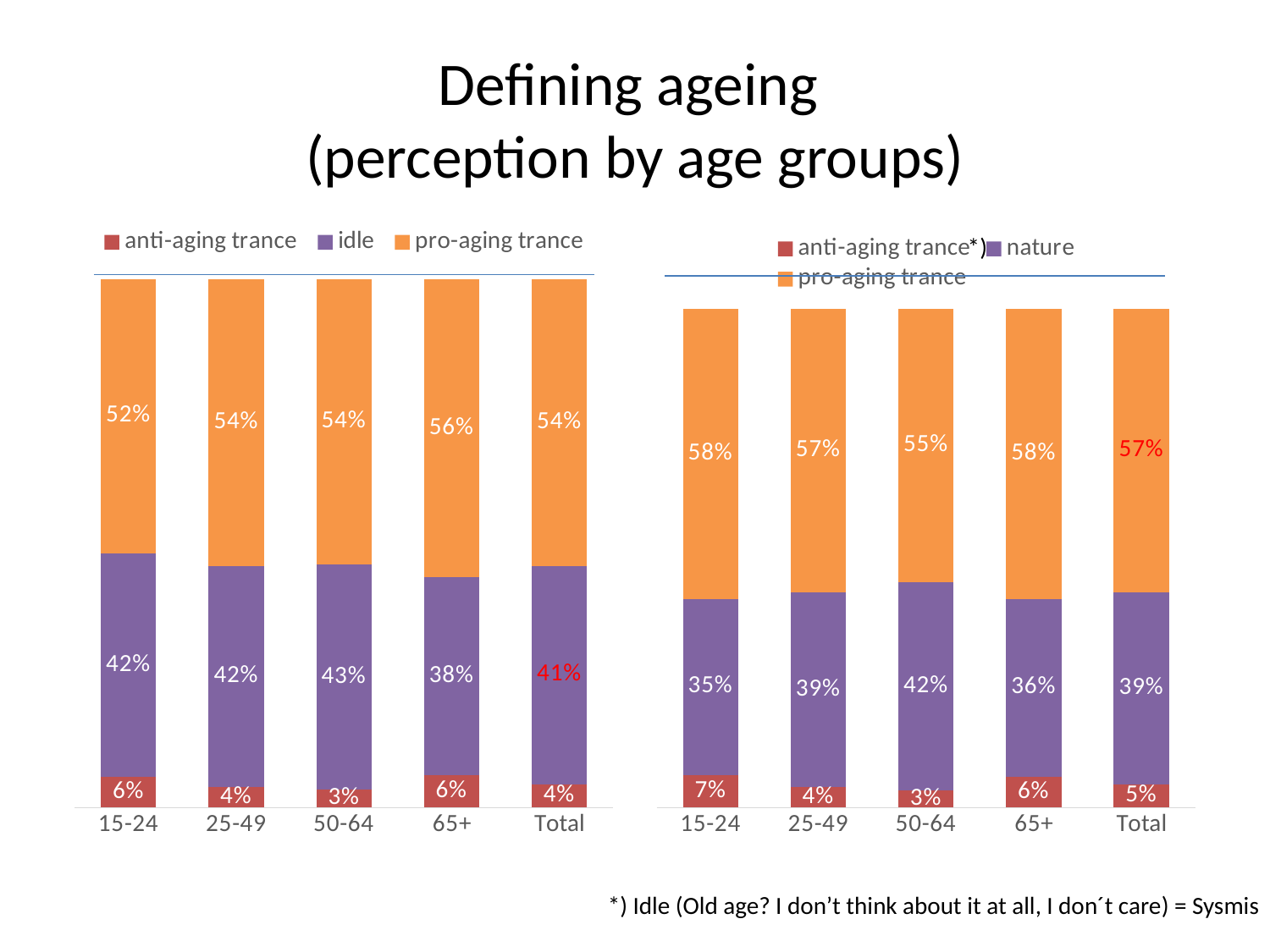
In the right chart, what is the value of nature for the 15-24 age group? 35% In the left chart, what is the pro-aging trance value for the Total category? 54% In the left chart, which is larger: the idle value for 25-49 or for 65+? 25-49 How many series does the legend of the right chart list? 3 How many age-group categories are shown on the x axis of the left chart? 5 In the left chart, which age group has the highest pro-aging trance value? 65+ What type of chart is the left chart? Stacked bar chart In the right chart, what is the anti-aging trance value for the 65+ age group? 6% In the left chart, what is the value of idle for the 50-64 age group? 43% In the right chart, what is the difference between the nature values for 50-64 and 15-24? 7% In the right chart, which category has the lowest anti-aging trance value? 50-64 In the right chart, what is the total of the stacked bar for the Total category? 101%